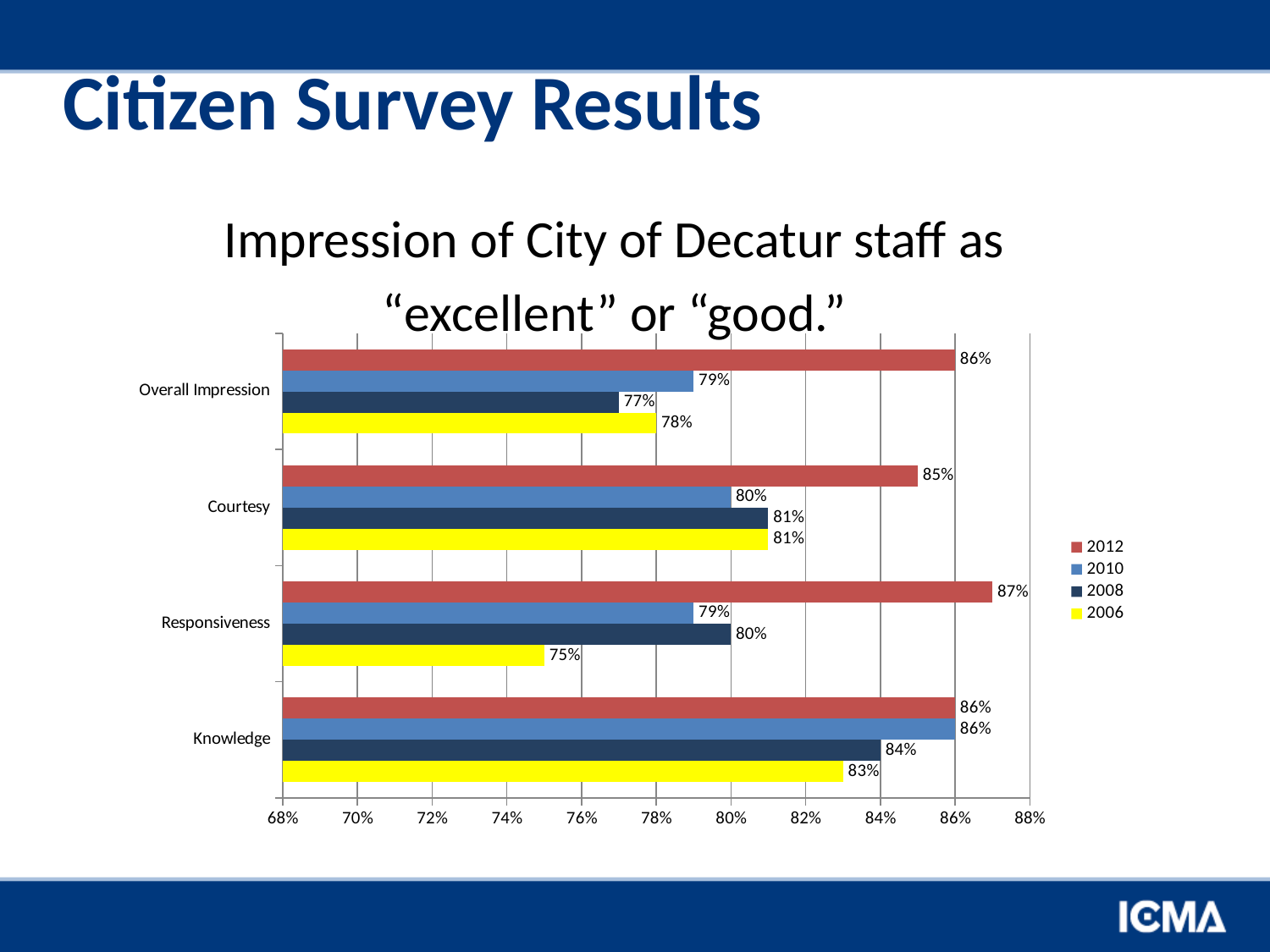
How many series does the legend list? 4 Which colour represents the 2006 series in the legend? Yellow What was the 2010 value for Courtesy? 80% Which is larger for Overall Impression: the 2010 value or the 2008 value? 2010 Which category had the lowest 2006 value? Responsiveness How many categories are shown on the chart? 4 What was the 2008 value for Overall Impression? 77% What was the 2012 value for Responsiveness? 87% Which category had the highest 2012 value? Responsiveness What kind of chart is shown on the slide? Bar chart What was the 2006 value for Knowledge? 83% What is the difference between the 2012 and 2006 values for Responsiveness? 12%